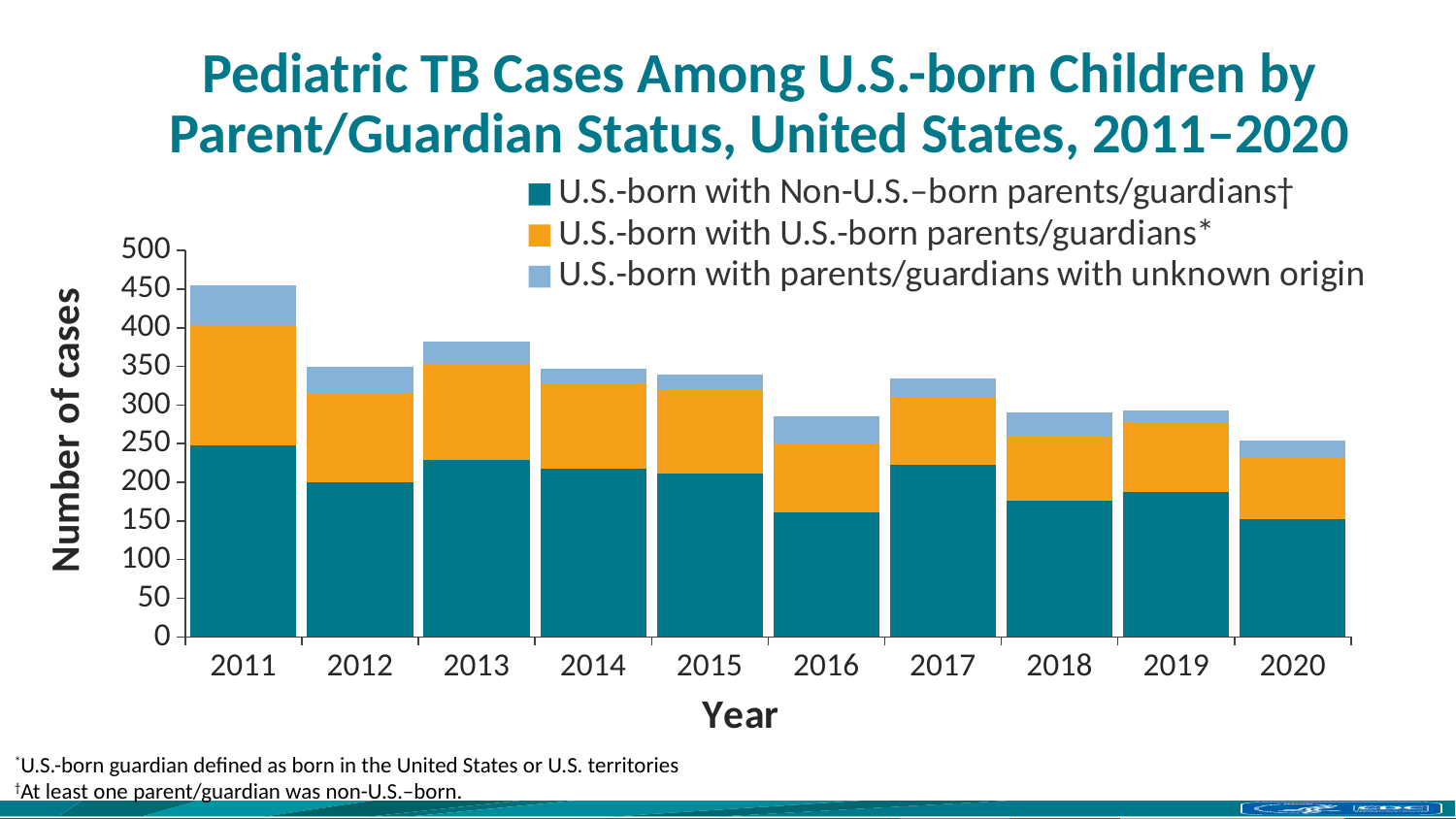
What type of chart is shown on the slide? Stacked bar chart Is the number of U.S.-born children with Non-U.S.-born parents/guardians in 2016 greater or less than 200? less Which year has the lowest total number of pediatric TB cases? 2020 How many series does the legend list? 3 How many years are shown on the x axis of the chart? 10 Is the total number of cases in 2013 greater or less than 350? greater Which year has the highest total number of pediatric TB cases? 2011 Is the total number of cases in 2011 greater or less than 400? greater Which series is shown in the light blue segments at the top of each bar? U.S.-born with parents/guardians with unknown origin Which year has a higher total number of cases, 2011 or 2012? 2011 Overall, do total pediatric TB cases rise or fall from 2011 to 2020? fall